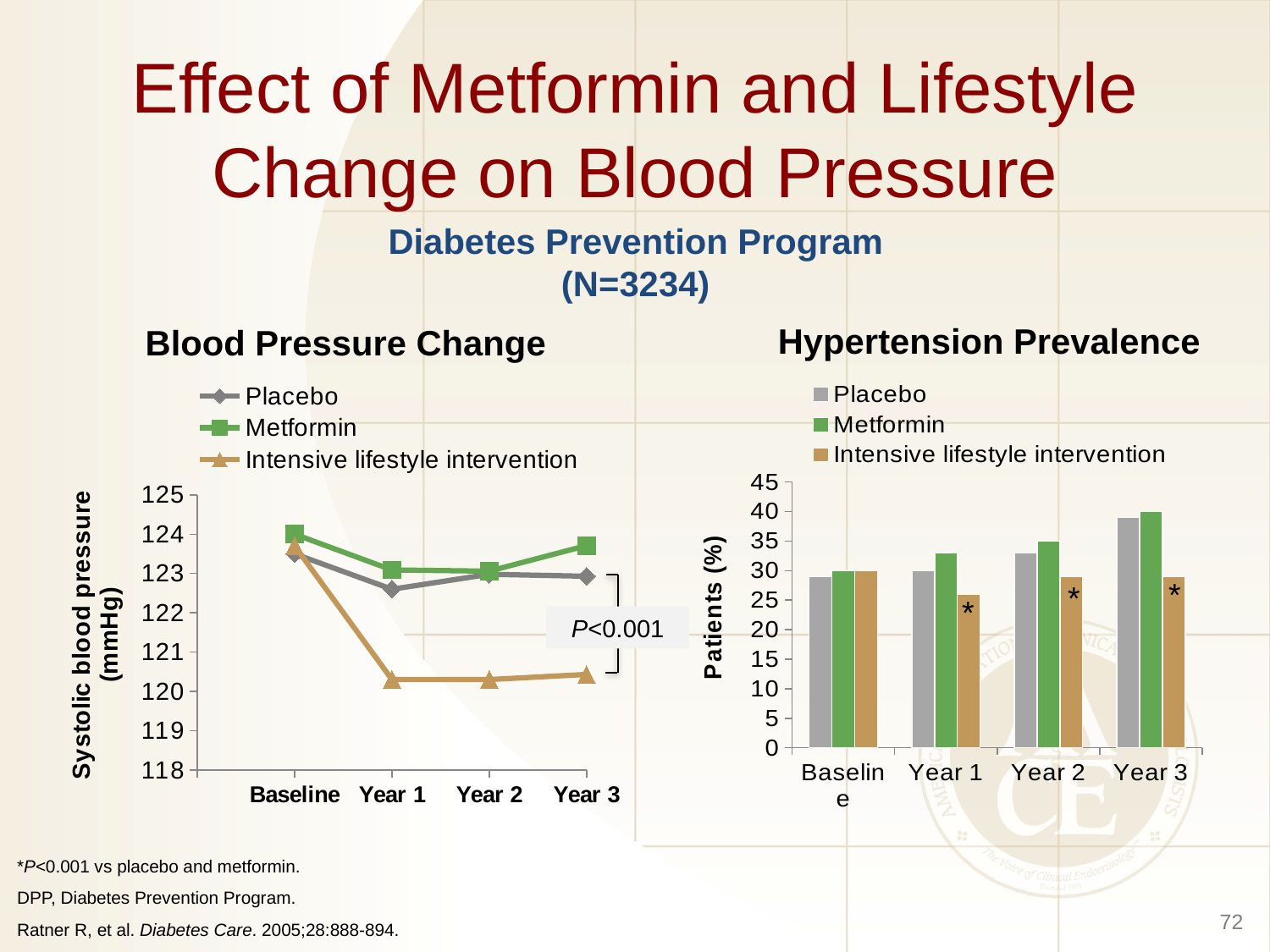
In the Hypertension Prevalence chart, is the value for Intensive lifestyle intervention at Year 1 greater or less than 30? less In the Hypertension Prevalence chart, what kind of chart is it? bar chart In the Blood Pressure Change chart, does the Intensive lifestyle intervention line rise or fall from Baseline to Year 1? fall In the Blood Pressure Change chart, how many series does the legend list? 3 In the Blood Pressure Change chart, what kind of chart is it? line chart In the Blood Pressure Change chart, is the value for Metformin at Baseline greater or less than 123? greater In the Hypertension Prevalence chart, which series has the lowest value at Year 3? Intensive lifestyle intervention In the Hypertension Prevalence chart, how many time points are shown on the x axis? 4 In the Blood Pressure Change chart, is the value for Intensive lifestyle intervention at Year 1 greater or less than 121? less In the Hypertension Prevalence chart, what is the label of the y axis? Patients (%) In the Blood Pressure Change chart, which series has the lowest value at Year 3? Intensive lifestyle intervention